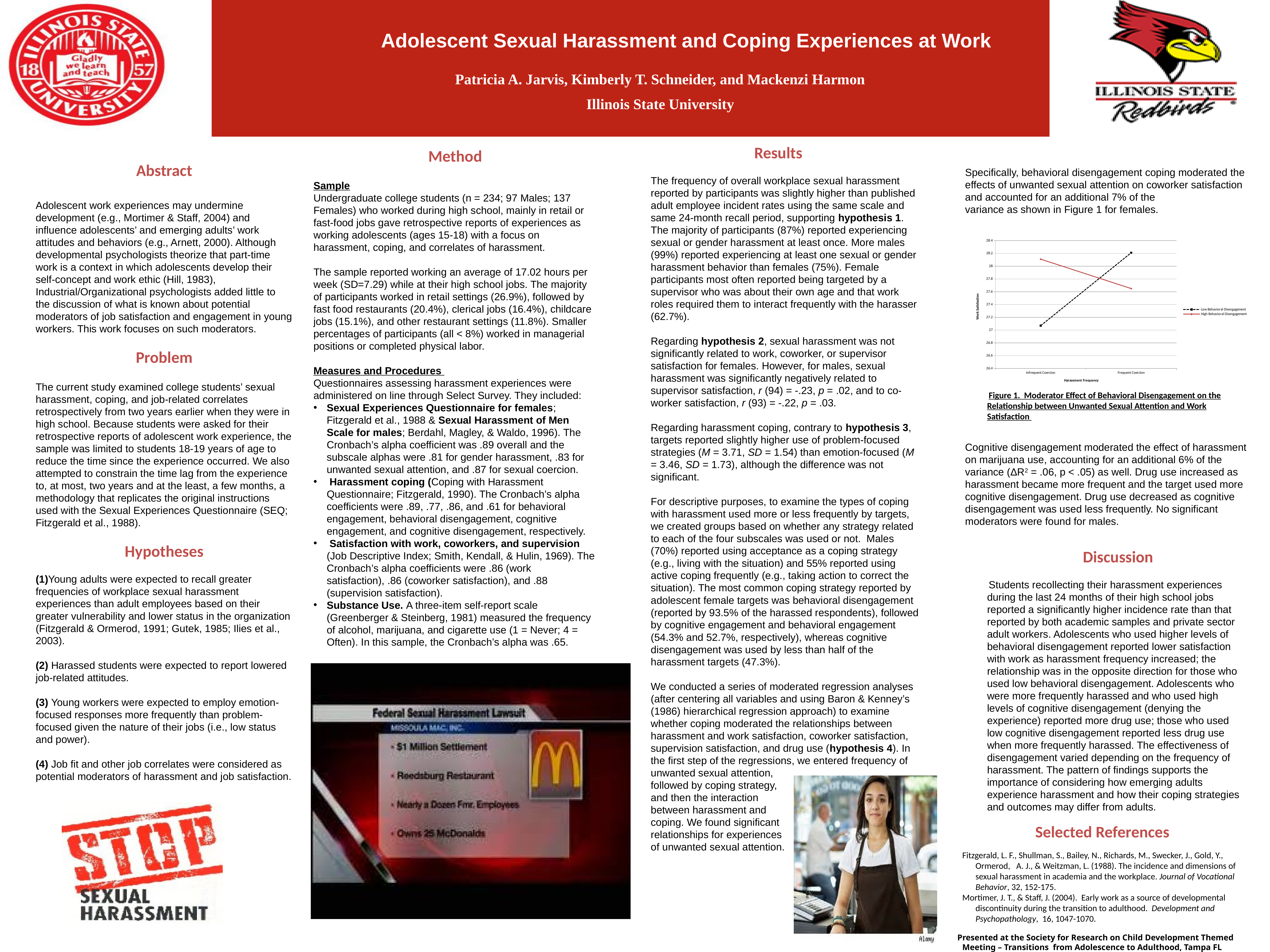
What kind of chart is shown in Figure 1? line chart How many series does the legend of Figure 1 list? 2 In Figure 1, does work satisfaction for Low Behavioral Disengagement rise or fall from Infrequent Coercion to Frequent Coercion? rise In Figure 1, is the work satisfaction value for Low Behavioral Disengagement at Infrequent Coercion greater or less than 27.4? less How many harassment frequency categories are shown on the x axis of Figure 1? 2 In Figure 1, at Infrequent Coercion, which series has higher work satisfaction: Low Behavioral Disengagement or High Behavioral Disengagement? High Behavioral Disengagement In Figure 1, is the work satisfaction value for High Behavioral Disengagement at Frequent Coercion greater or less than 28? less In Figure 1, does work satisfaction for High Behavioral Disengagement rise or fall from Infrequent Coercion to Frequent Coercion? fall What is the label of the x axis in Figure 1? Harassment Frequency In Figure 1, at Frequent Coercion, which series has higher work satisfaction: Low Behavioral Disengagement or High Behavioral Disengagement? Low Behavioral Disengagement What is the label of the y axis in Figure 1? Work Satisfaction In Figure 1, is the work satisfaction value for Low Behavioral Disengagement at Frequent Coercion greater or less than 28? greater